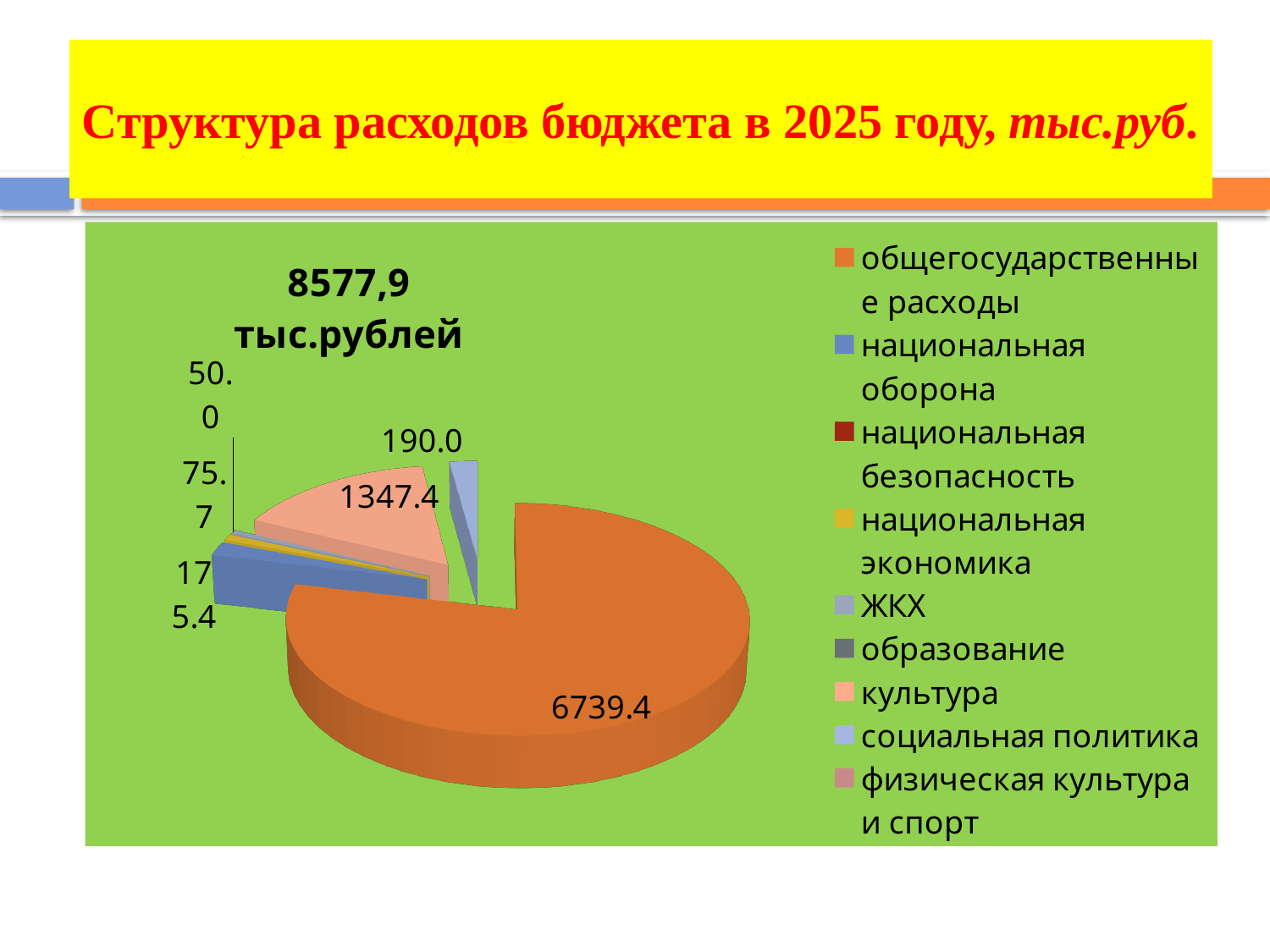
What is the value of the largest slice? 6739.4 How many categories does the legend list? 9 Which is larger, the value for общегосударственные расходы or the value for культура? общегосударственные расходы What type of chart is shown on the slide? pie chart Which category has the largest slice of the pie? общегосударственные расходы What is the title shown above the pie chart? 8577,9 тыс.рублей What colour is the largest slice of the pie? orange What is the difference between the values for общегосударственные расходы and культура? 5392.0 What is the value for общегосударственные расходы? 6739.4 Is the value for культура greater or less than 1000? greater What is the difference between the slice labelled 1347.4 and the slice labelled 190.0? 1157.4 What is the value for культура? 1347.4